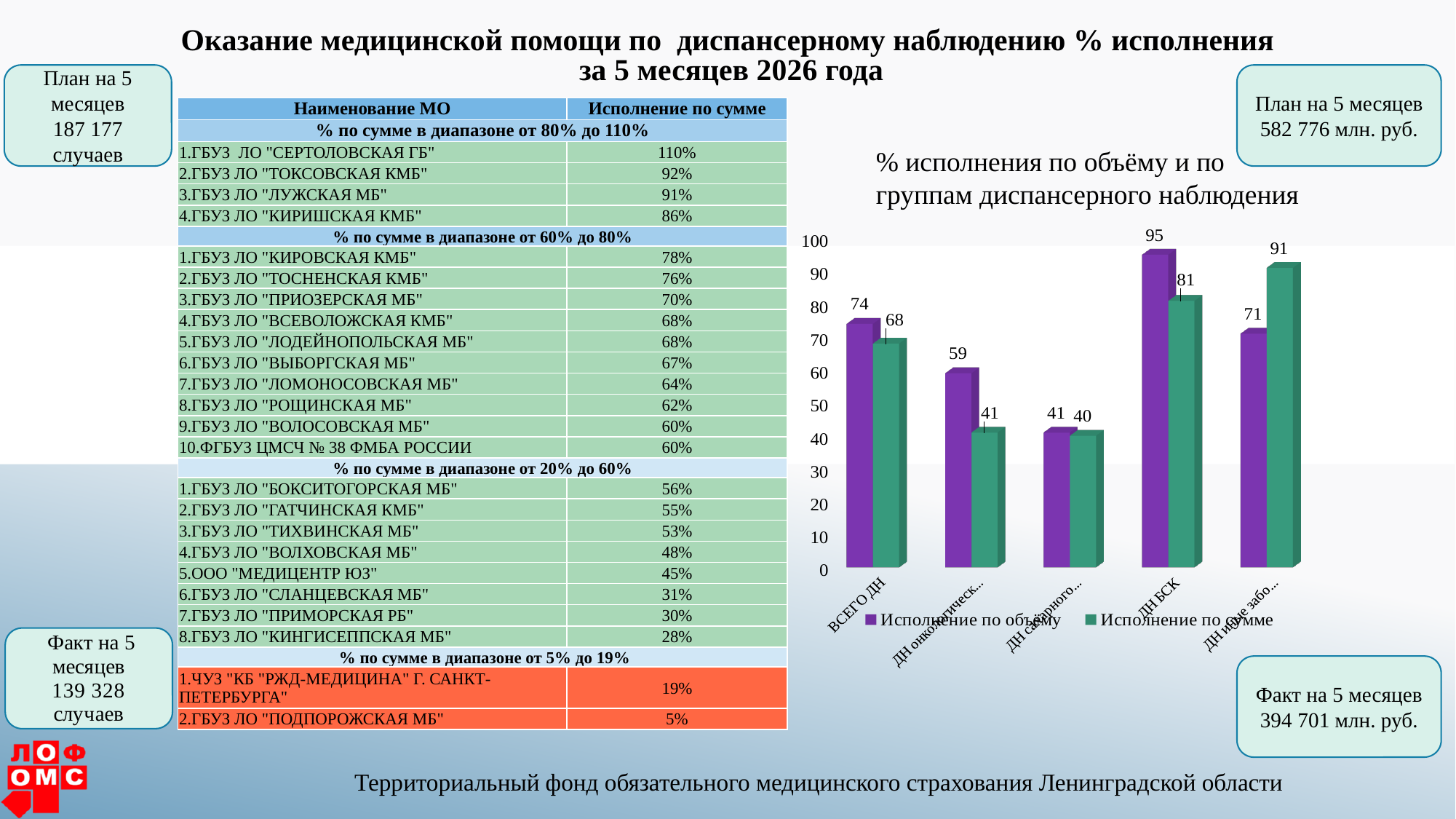
What is the value of "Исполнение по объёму" for "ВСЕГО ДН"? 74 How many series does the chart legend list? 2 Which category has the highest value for "Исполнение по объёму"? ДН БСК What colour are the bars for the "Исполнение по объёму" series? purple What is the difference between "Исполнение по объёму" and "Исполнение по сумме" for "ДН БСК"? 14 What is the value of "Исполнение по сумме" for "ДН БСК"? 81 What is the value of "Исполнение по сумме" for "ВСЕГО ДН"? 68 How many categories are plotted along the x axis of the chart? 5 For "ВСЕГО ДН", which is larger: "Исполнение по объёму" or "Исполнение по сумме"? Исполнение по объёму What is the value of "Исполнение по объёму" for "ДН БСК"? 95 What is the value of "Исполнение по сумме" for the last (rightmost) category on the chart? 91 What kind of chart is shown on the slide? bar chart